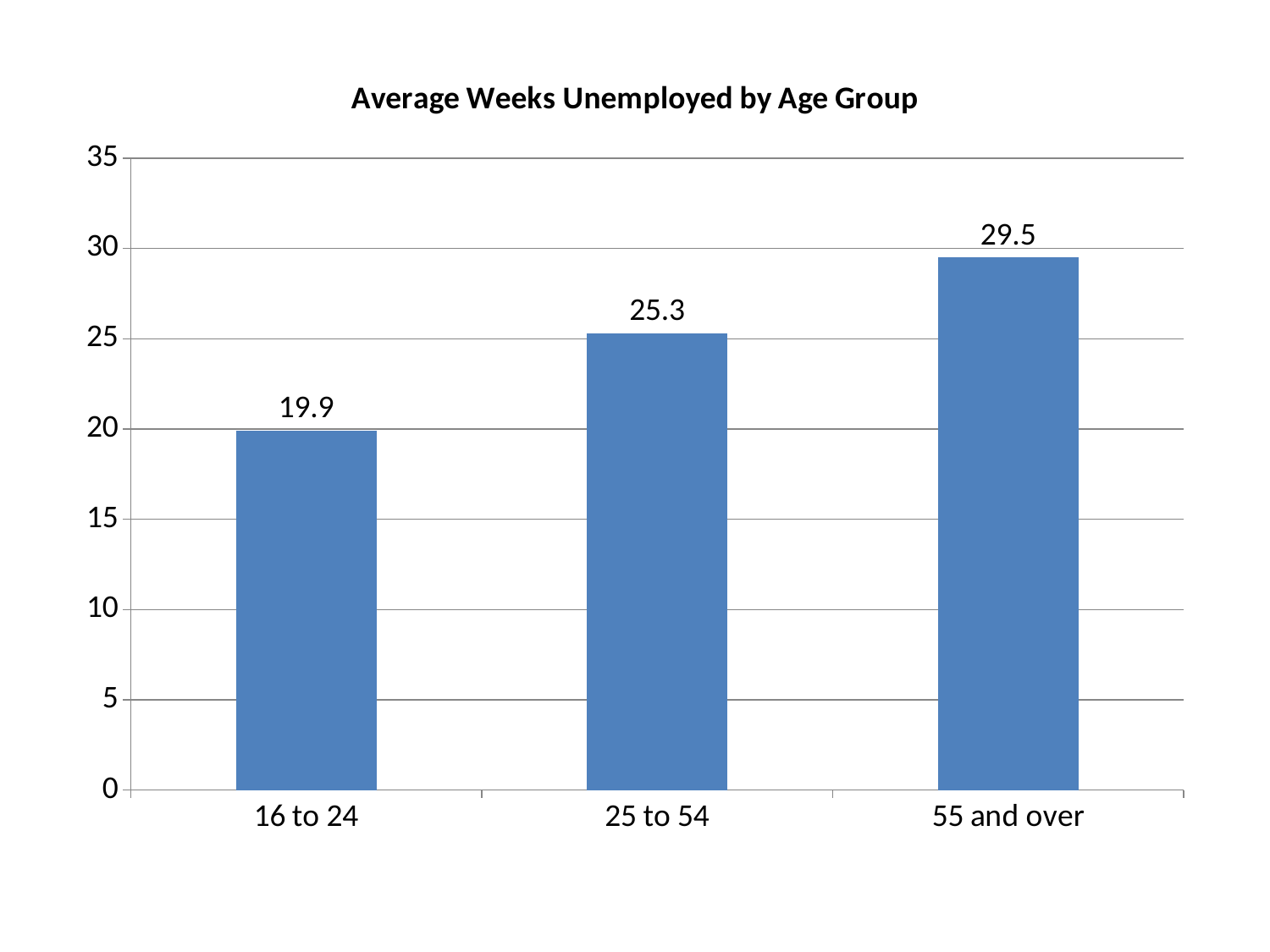
Which has a higher average weeks unemployed, 25 to 54 or 55 and over? 55 and over What is the average weeks unemployed for the 25 to 54 age group? 25.3 What is the difference in average weeks unemployed between the 55 and over group and the 16 to 24 group? 9.6 What is the average weeks unemployed for the 55 and over age group? 29.5 Is the value for 25 to 54 greater or less than 25? greater Which age group has the highest average weeks unemployed? 55 and over What is the difference in average weeks unemployed between the 25 to 54 group and the 16 to 24 group? 5.4 Which age group has the lowest average weeks unemployed? 16 to 24 How many age groups are shown in the chart? 3 What is the average weeks unemployed for the 16 to 24 age group? 19.9 Do the values rise or fall from the youngest to the oldest age group? Rise What kind of chart is shown on the slide? Bar chart